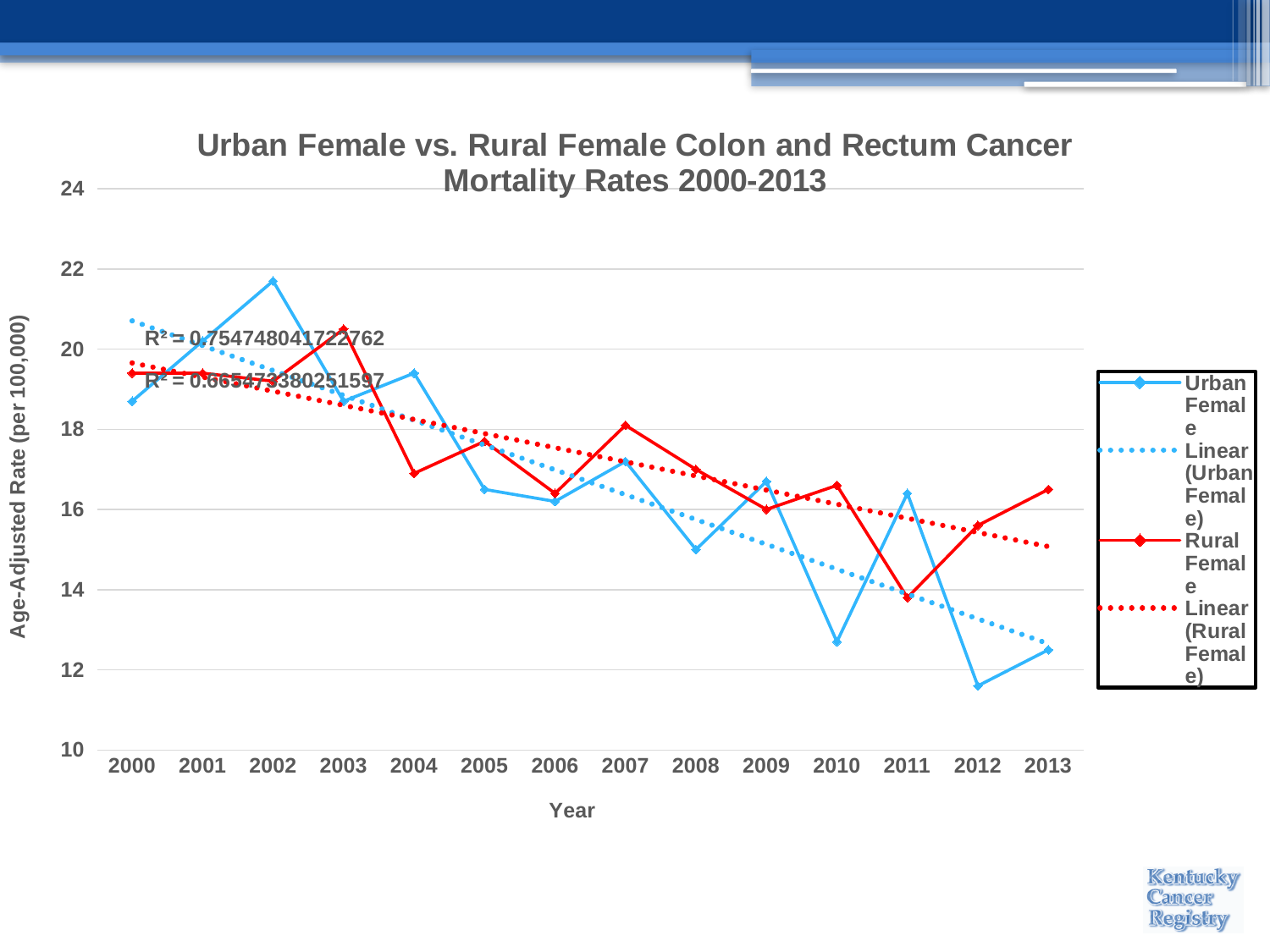
In which year is the Rural Female mortality rate highest? 2003 In which year is the Rural Female mortality rate lowest? 2011 Overall, do the Urban Female mortality rates rise or fall from 2000 to 2013? Fall In which year is the Urban Female mortality rate lowest? 2012 In 2010, which series has the larger value, Urban Female or Rural Female? Rural Female How many entries does the legend list? 4 What kind of chart is shown on the slide? Line chart In which year is the Urban Female mortality rate highest? 2002 What is the title of the chart? Urban Female vs. Rural Female Colon and Rectum Cancer Mortality Rates 2000-2013 How many years are shown on the x axis? 14 Is the Rural Female value for 2011 greater or less than 14? less Is the Urban Female value for 2002 greater or less than 20? greater